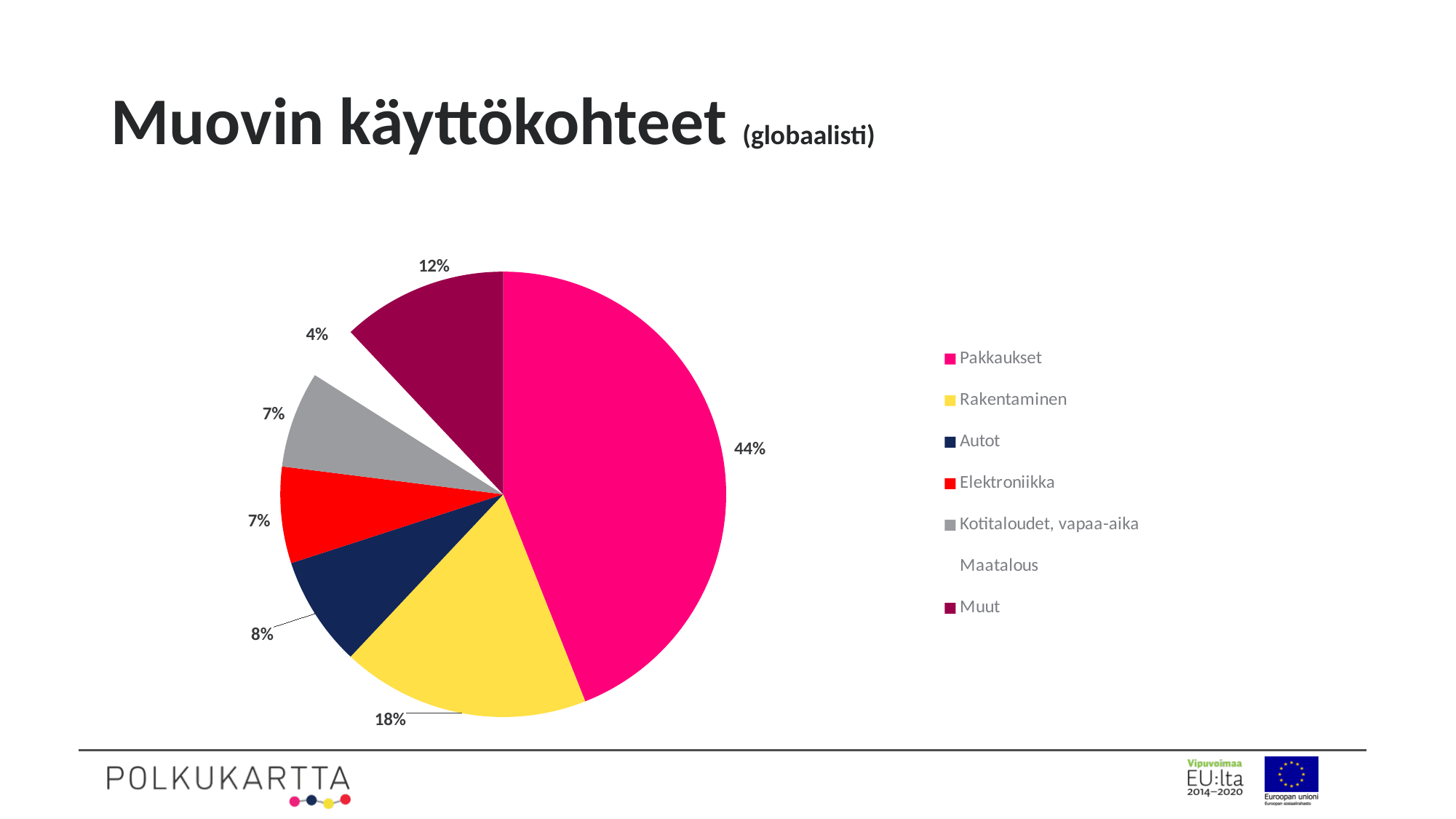
Which is larger, the share for Muut or the share for Autot? Muut What is the value shown for Autot? 8% How many categories does the legend list? 7 Which category has the smallest slice of the pie? Maatalous What is the title of the slide containing the chart? Muovin käyttökohteet (globaalisti) Which category has the largest slice of the pie? Pakkaukset What kind of chart is shown on the slide? Pie chart What share of the pie does Pakkaukset have? 44% What is the difference between the shares of Pakkaukset and Rakentaminen? 26% What is the value shown for Maatalous? 4% What is the value shown for Rakentaminen? 18% What is the value shown for Muut? 12%